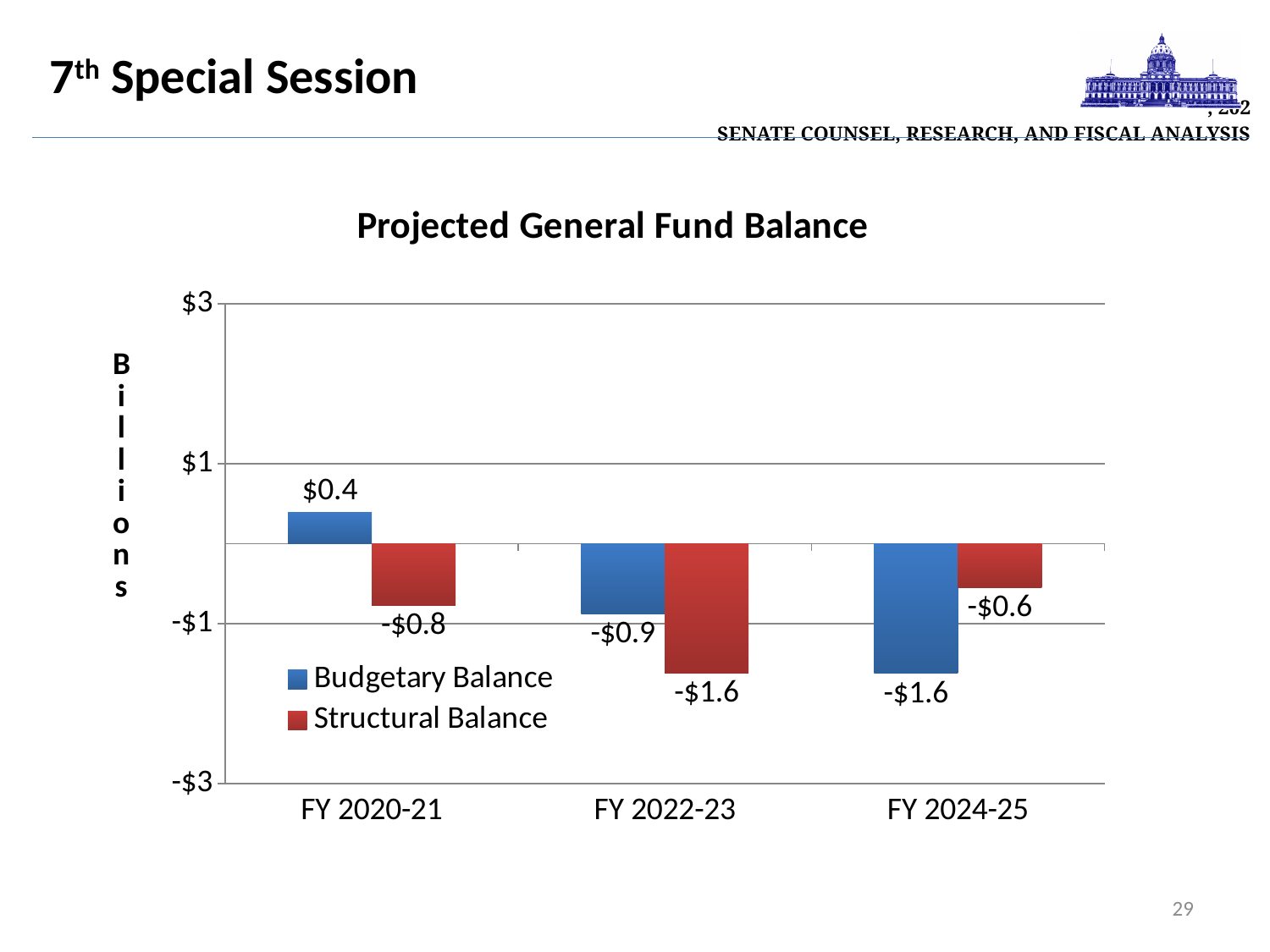
What is the Budgetary Balance for FY 2024-25? -$1.6 What is the title of the chart? Projected General Fund Balance What is the difference between the Budgetary Balance and the Structural Balance in FY 2024-25? $1.0 Which is larger in FY 2022-23, the Budgetary Balance or the Structural Balance? Budgetary Balance Which fiscal year has the lowest Structural Balance? FY 2022-23 What kind of chart is shown on the slide? Bar chart Which fiscal year has the highest Budgetary Balance? FY 2020-21 What is the Budgetary Balance for FY 2020-21? $0.4 What is the Structural Balance for FY 2022-23? -$1.6 How many fiscal years are shown on the x axis? 3 What is the Structural Balance for FY 2020-21? -$0.8 How many series does the legend list? 2